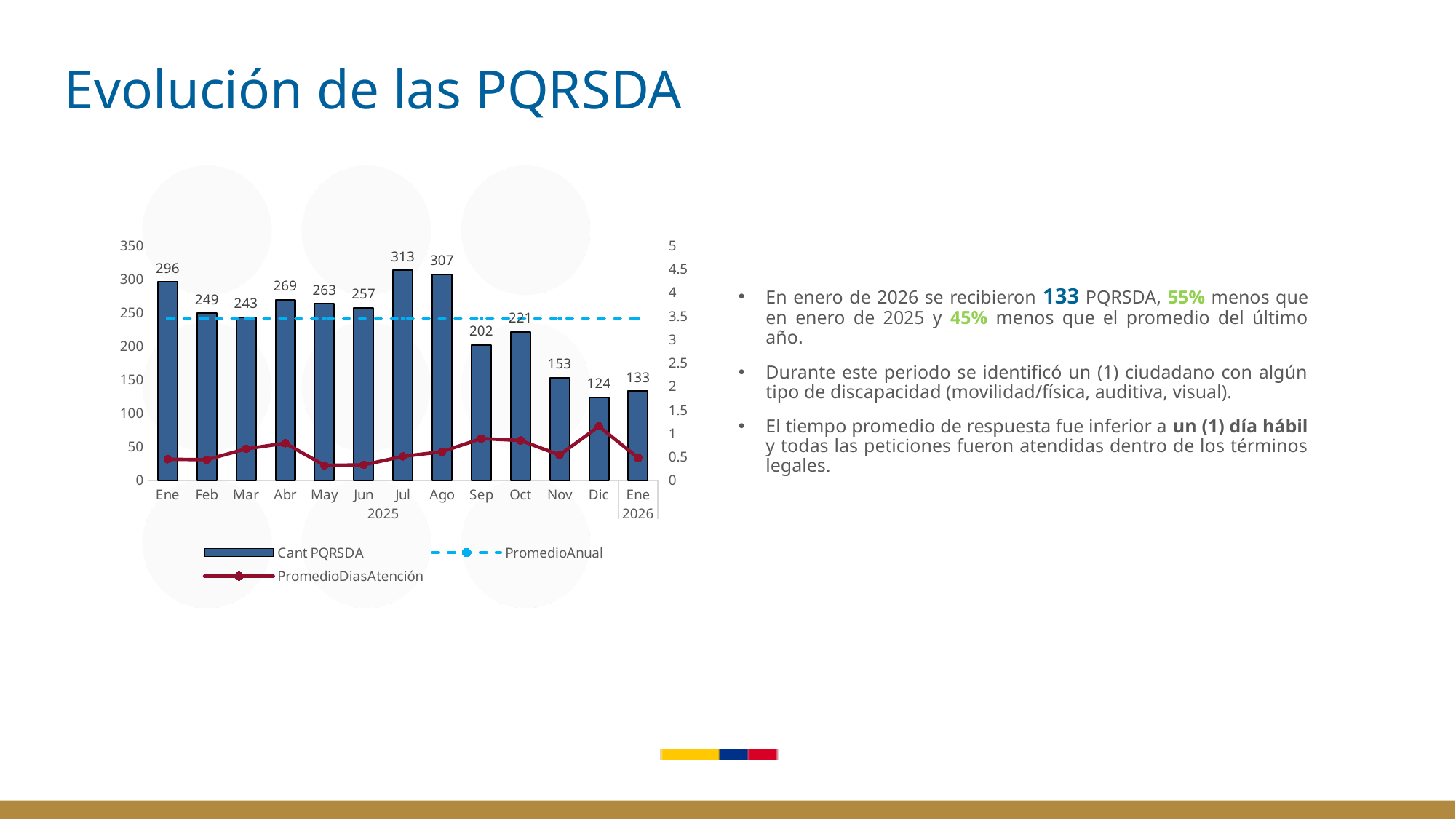
Which month has the lowest Cant PQRSDA value? Dic 2025 Which month has the highest Cant PQRSDA value? Jul 2025 What is the difference between the Cant PQRSDA values for Ene 2025 and Ene 2026? 163 What kind of chart is used for the Cant PQRSDA series? Bar chart Which is larger, the Cant PQRSDA value for Sep 2025 or for Oct 2025? Oct 2025 How many series does the chart legend list? 3 What is the Cant PQRSDA value for Ene 2026? 133 Do the Cant PQRSDA values generally rise or fall from Ago 2025 to Dic 2025? Fall Is the PromedioDiasAtención value for Dic 2025 greater or less than 1.5? less How many months are shown on the x axis of the chart? 13 What is the Cant PQRSDA value for Nov 2025? 153 What is the Cant PQRSDA value for Jul 2025? 313